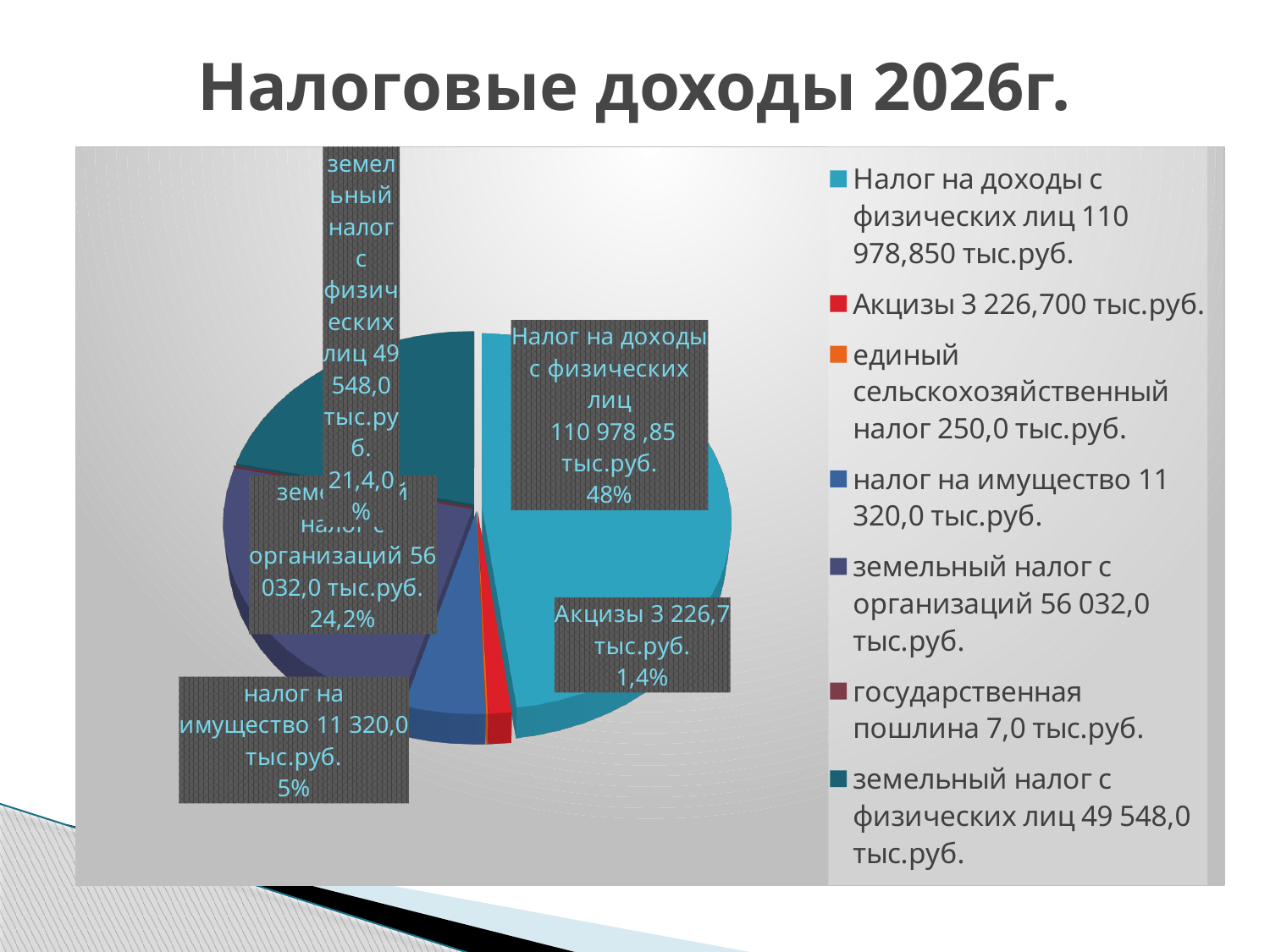
What is the value of налог на имущество? 11 320,0 тыс.руб. How many categories does the legend list? 7 What share of the pie does Акцизы have? 1,4% What share of the pie does земельный налог с организаций have? 24,2% What share of the pie does Налог на доходы с физических лиц have? 48% What is the value of единый сельскохозяйственный налог? 250,0 тыс.руб. What is the value of земельный налог с физических лиц? 49 548,0 тыс.руб. Which category has the smallest value according to the legend? государственная пошлина Which category has the largest share of the pie? Налог на доходы с физических лиц What is the title of the slide's chart? Налоговые доходы 2026г. What kind of chart is shown on the slide? pie chart Which is larger, земельный налог с организаций or земельный налог с физических лиц? земельный налог с организаций